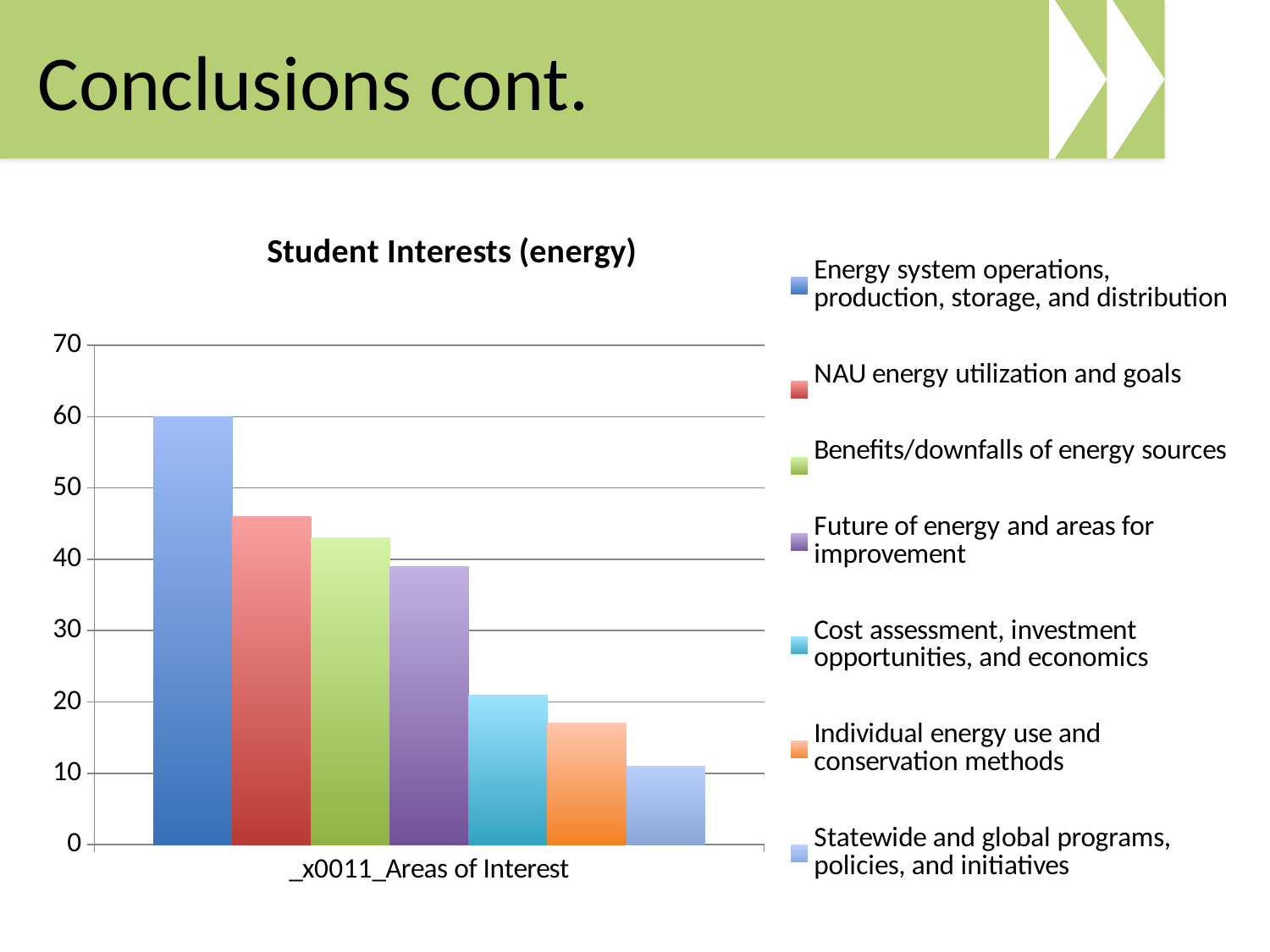
What is the value for Energy system operations, production, storage, and distribution? 60 How many series does the legend list? 7 Which is larger: the value for Cost assessment, investment opportunities, and economics or the value for Individual energy use and conservation methods? Cost assessment, investment opportunities, and economics What kind of chart is shown on the slide? bar chart What is the title of the chart? Student Interests (energy) Which series has the highest value? Energy system operations, production, storage, and distribution Is the value for Benefits/downfalls of energy sources greater or less than 40? greater Is the value for NAU energy utilization and goals greater or less than 50? less Which series has the lowest value? Statewide and global programs, policies, and initiatives